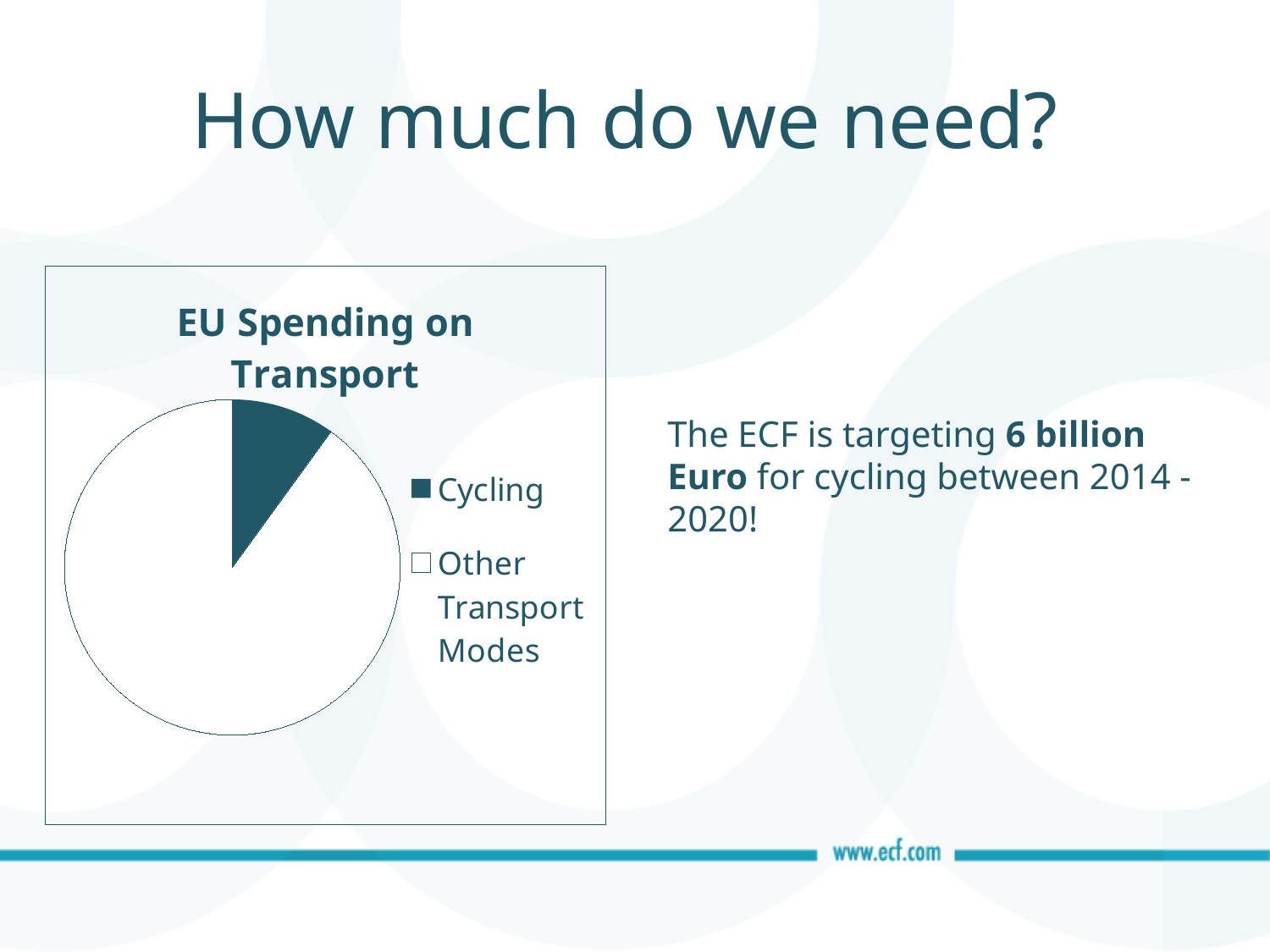
Which slice of the pie is the largest? Other Transport Modes How many entries does the legend list? 2 How many slices does the pie chart have? 2 Which slice of the pie is the smallest? Cycling Which is larger, the Cycling slice or the Other Transport Modes slice? Other Transport Modes What is the title of the chart? EU Spending on Transport Which legend entry is shown with a solid dark teal fill? Cycling What kind of chart is shown on the slide? pie chart